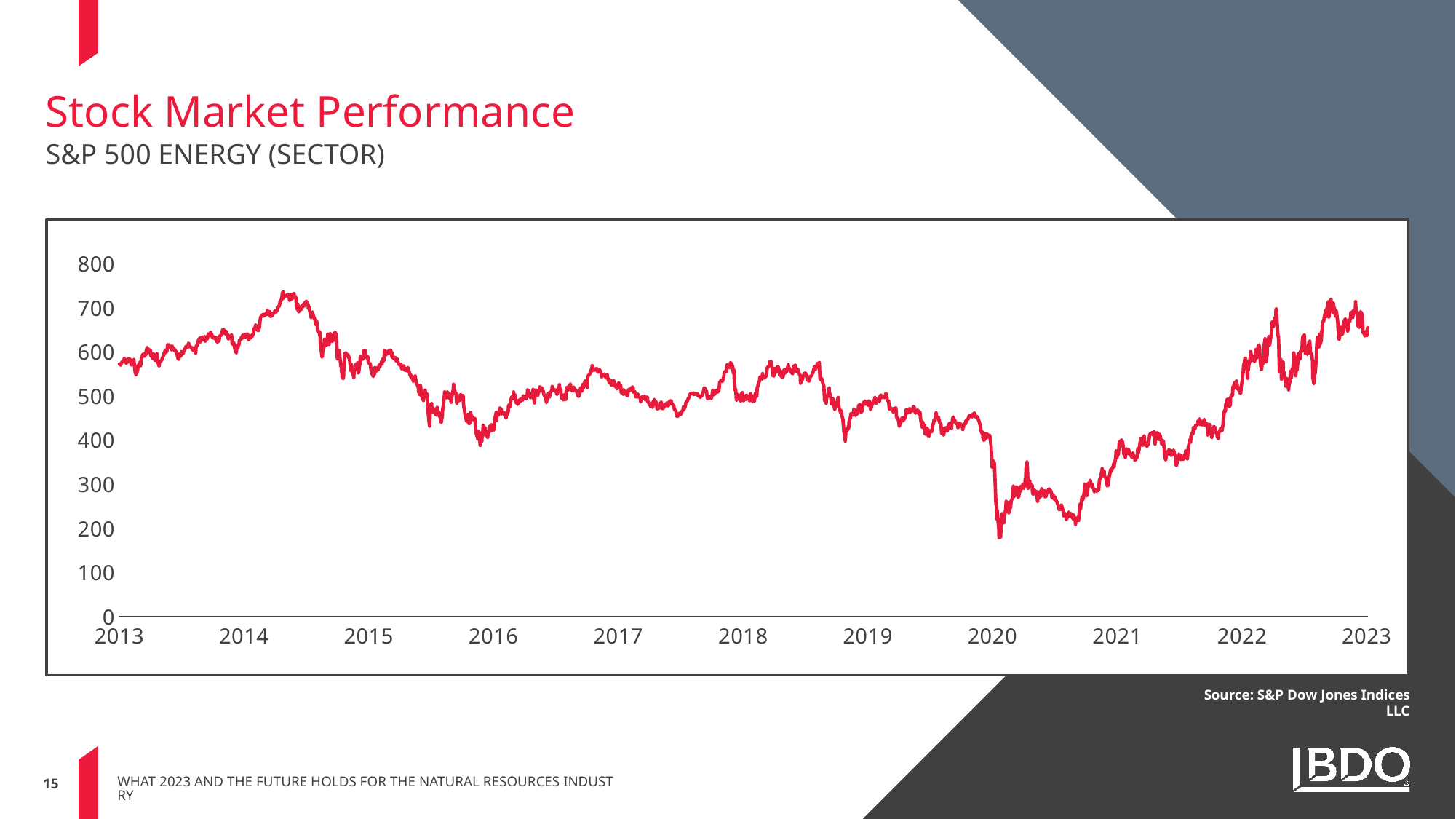
Which index does the chart track, according to the subtitle? S&P 500 ENERGY (SECTOR) What is the title of the chart on the slide? Stock Market Performance How many year labels are shown on the x axis? 11 Is the value at the start of 2013 greater or less than 500? greater Is the lowest value reached in 2020 greater or less than 300? less Is the value at the start of 2023 greater or less than 600? greater In which year does the line reach its lowest point? 2020 What kind of chart is shown on the slide? line chart Does the line generally rise or fall between its 2014 peak and the start of 2016? fall Does the line generally rise or fall between 2020 and 2022? rise Is the value at the start of 2021 larger or smaller than the value at the start of 2013? smaller